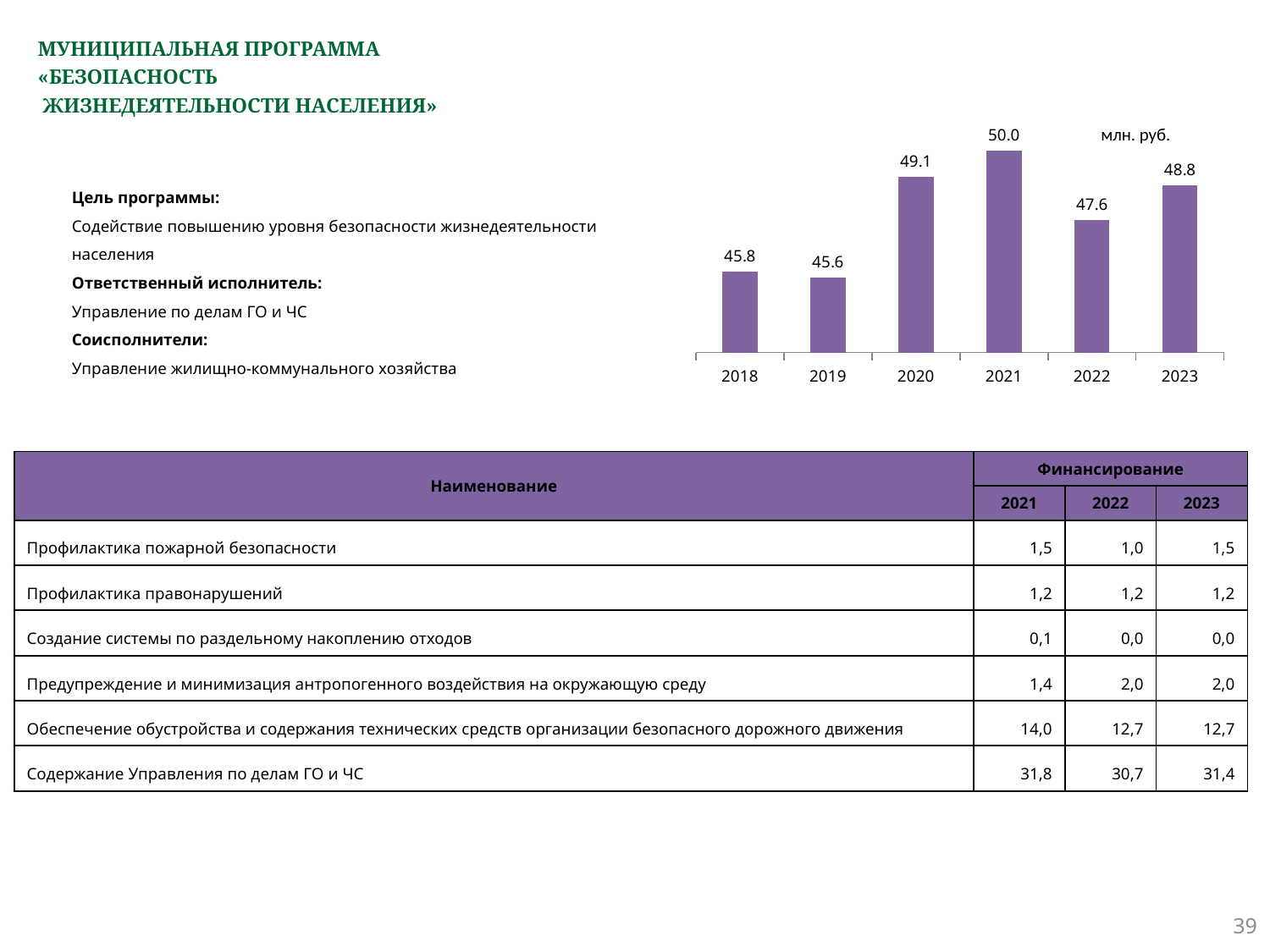
Which year has the lowest value on the bar chart? 2019 Which year has the highest value on the bar chart? 2021 How many years are shown on the bar chart? 6 What is the difference between the values for 2021 and 2022 on the bar chart? 2.4 What is the value for 2018 on the bar chart? 45.8 What is the value for 2023 on the bar chart? 48.8 What unit is indicated next to the bar chart? млн. руб. Which is larger on the bar chart, the value for 2020 or the value for 2023? 2020 What is the value for 2021 on the bar chart? 50.0 What is the difference between the values for 2020 and 2018 on the bar chart? 3.3 Does the value on the bar chart rise or fall from 2021 to 2022? fall What kind of chart is shown on the slide? bar chart